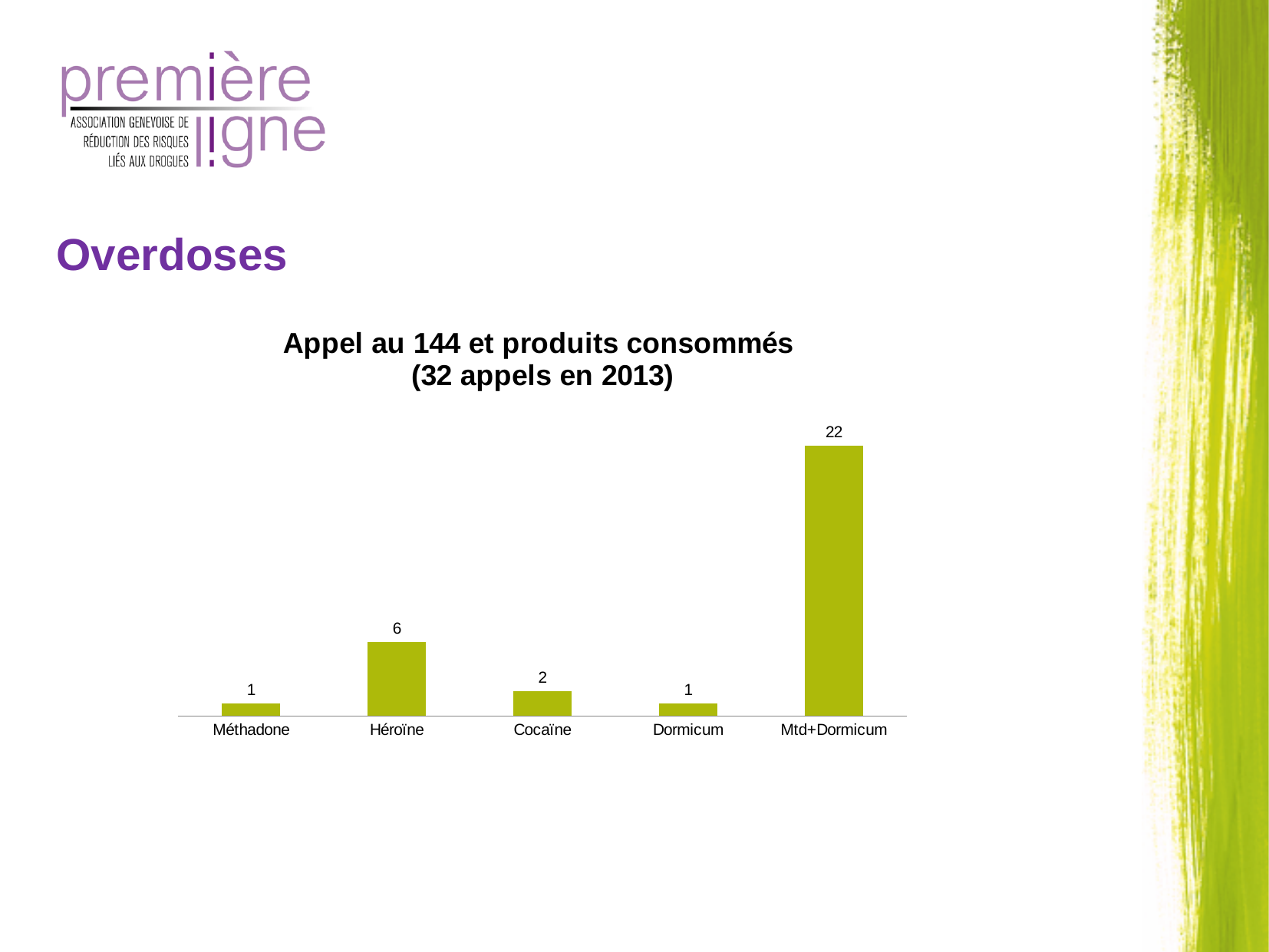
What is the value for Héroïne? 6 Which category has the highest value? Mtd+Dormicum What kind of chart is shown? Bar chart What is the value for Méthadone? 1 What is the total of all the values shown in the chart? 32 What is the difference between the values for Mtd+Dormicum and Héroïne? 16 What is the title of the chart? Appel au 144 et produits consommés (32 appels en 2013) What is the value for Mtd+Dormicum? 22 How many categories are shown on the x axis? 5 What is the value for Cocaïne? 2 What is the difference between the values for Héroïne and Cocaïne? 4 Which is larger, the value for Héroïne or the value for Cocaïne? Héroïne